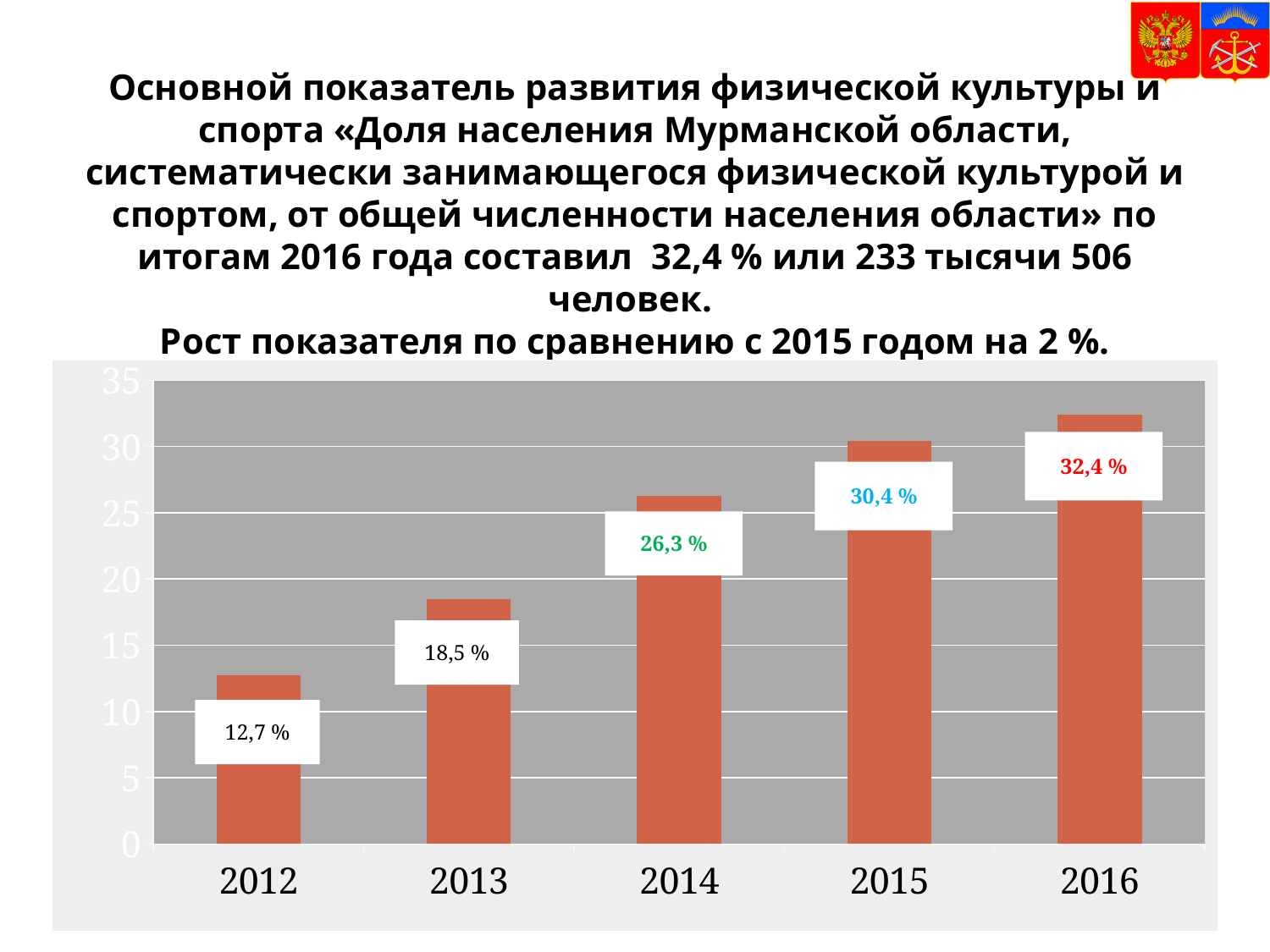
Which is larger, the value for 2013 or the value for 2015? 2015 Is the value for 2013 greater or less than 20? less What is the value for 2014? 26,3 % What is the difference between the values for 2014 and 2013? 7,8 % Do the values rise or fall from 2012 to 2016? rise Which year has the lowest value? 2012 Which year has the highest value? 2016 What kind of chart is this? bar chart What is the value for 2016? 32,4 % How many years are shown on the x axis? 5 What is the value for 2012? 12,7 % What is the difference between the values for 2016 and 2015? 2 %